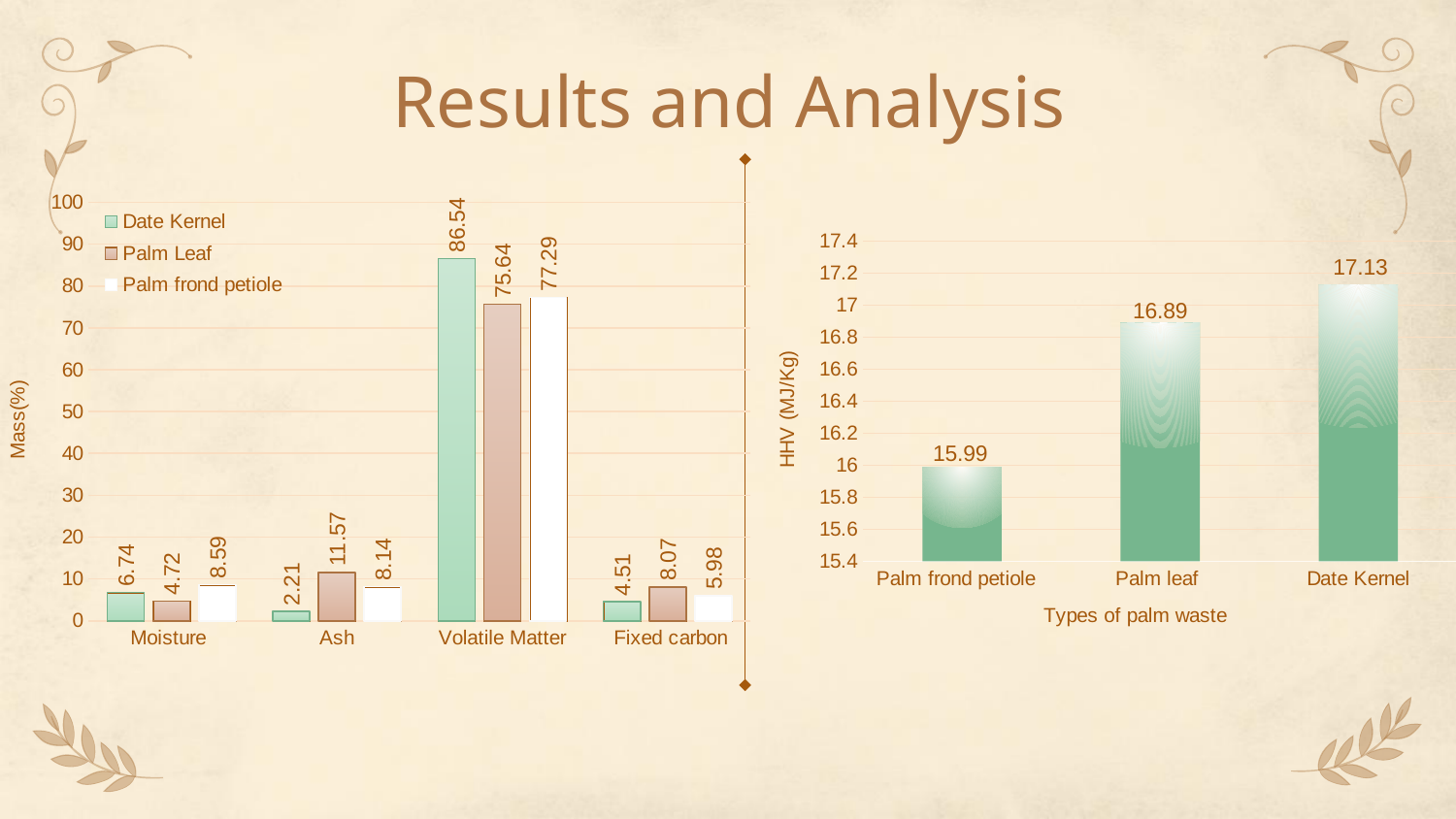
In the left chart (Mass(%)), what is the difference between the Volatile Matter values of Date Kernel and Palm Leaf? 10.90 In the left chart (Mass(%)), what is the Moisture value for Palm frond petiole? 8.59 In the right chart (HHV (MJ/Kg)), what is the HHV value for Palm leaf? 16.89 In the left chart (Mass(%)), what is the Volatile Matter value for Date Kernel? 86.54 In the left chart (Mass(%)), how many categories are shown on the x axis? 4 In the left chart (Mass(%)), how many series does the legend list? 3 In the right chart (HHV (MJ/Kg)), which type of palm waste has the highest HHV? Date Kernel In the left chart (Mass(%)), which series has the highest Ash value? Palm Leaf What kind of chart is the right chart (HHV (MJ/Kg))? Bar chart In the left chart (Mass(%)), which series has the lowest Fixed carbon value? Date Kernel In the left chart (Mass(%)), what is the Ash value for Palm Leaf? 11.57 In the right chart (HHV (MJ/Kg)), what is the difference between the HHV of Date Kernel and Palm frond petiole? 1.14